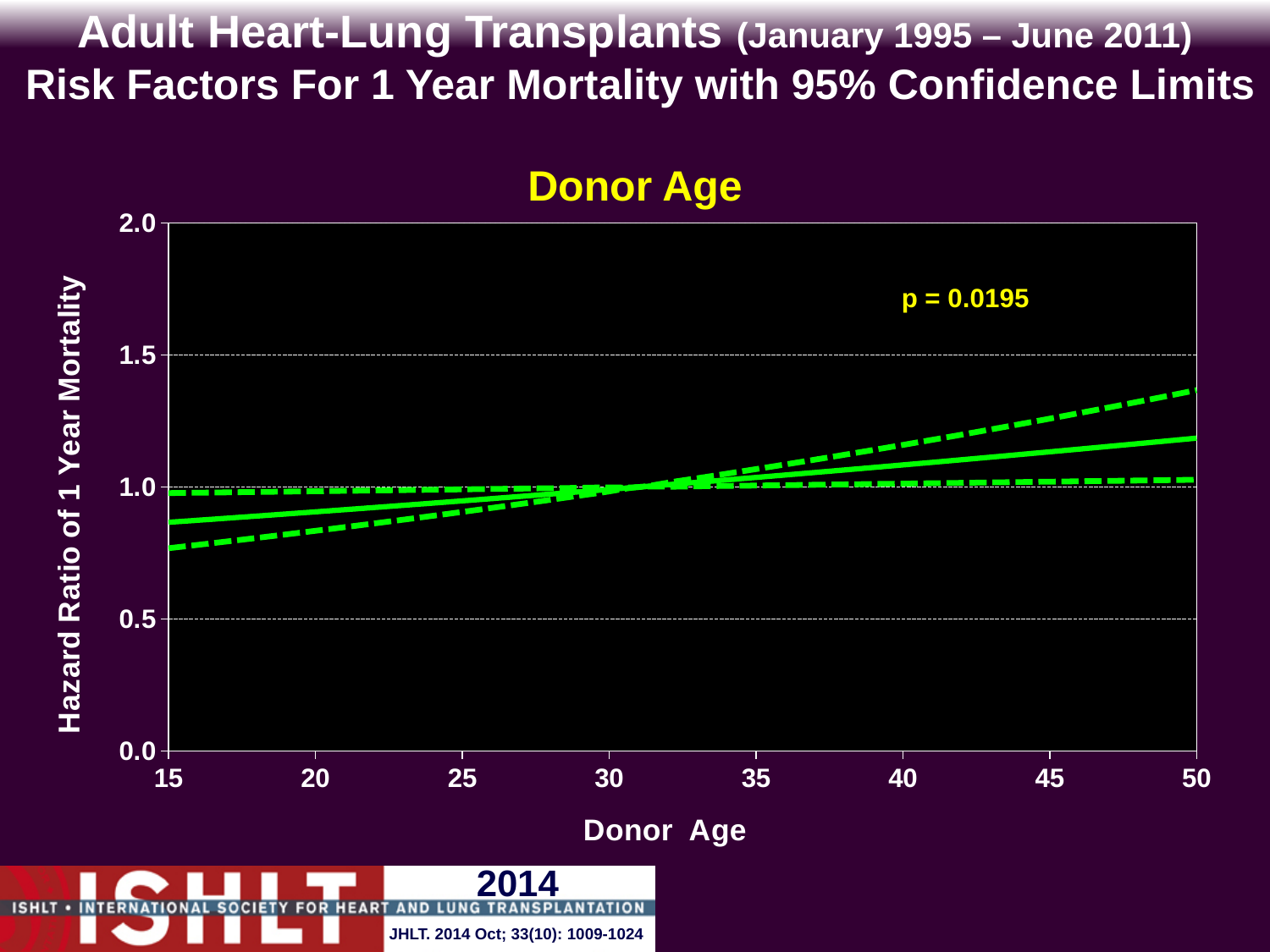
At donor age 50, is the upper 95% confidence limit (upper dashed line) greater or less than 1.0? greater What range of donor ages does the x axis cover? 15 to 50 What is the title of the chart? Donor Age How many lines are plotted on the chart? 3 At donor age 15, is the lower 95% confidence limit (lower dashed line) greater or less than 1.0? less What kind of chart is shown on the slide? line chart What is the maximum value shown on the y axis? 2.0 What p-value is printed on the chart? p = 0.0195 At donor age 15, is the hazard ratio shown by the solid line greater or less than 1.0? less Does the hazard ratio of 1 year mortality rise or fall as donor age increases from 15 to 50? rises